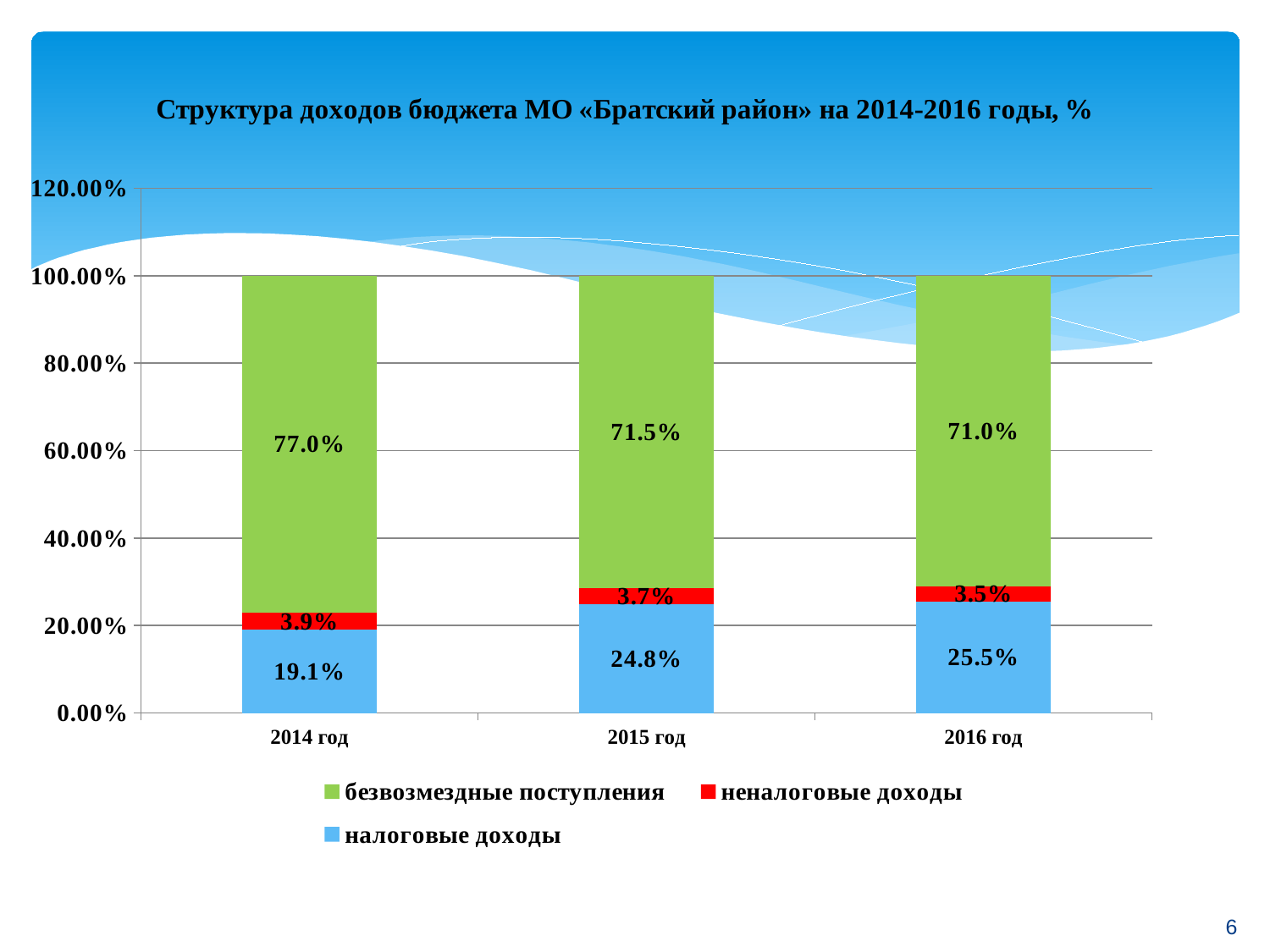
What is the value for безвозмездные поступления in 2014 год? 77.0% How many series does the legend list? 3 Does the share of безвозмездные поступления rise or fall from 2014 год to 2016 год? Fall In which year is the share of налоговые доходы lowest? 2014 год How many years are shown on the x axis? 3 What is the value for неналоговые доходы in 2015 год? 3.7% Which colour represents неналоговые доходы in the chart? Red What is the difference between the налоговые доходы values for 2016 год and 2014 год? 6.4% What kind of chart is shown on the slide? Stacked bar chart What is the value for налоговые доходы in 2016 год? 25.5% Which is larger: безвозмездные поступления in 2015 год or in 2016 год? 2015 год In which year is the share of безвозмездные поступления highest? 2014 год